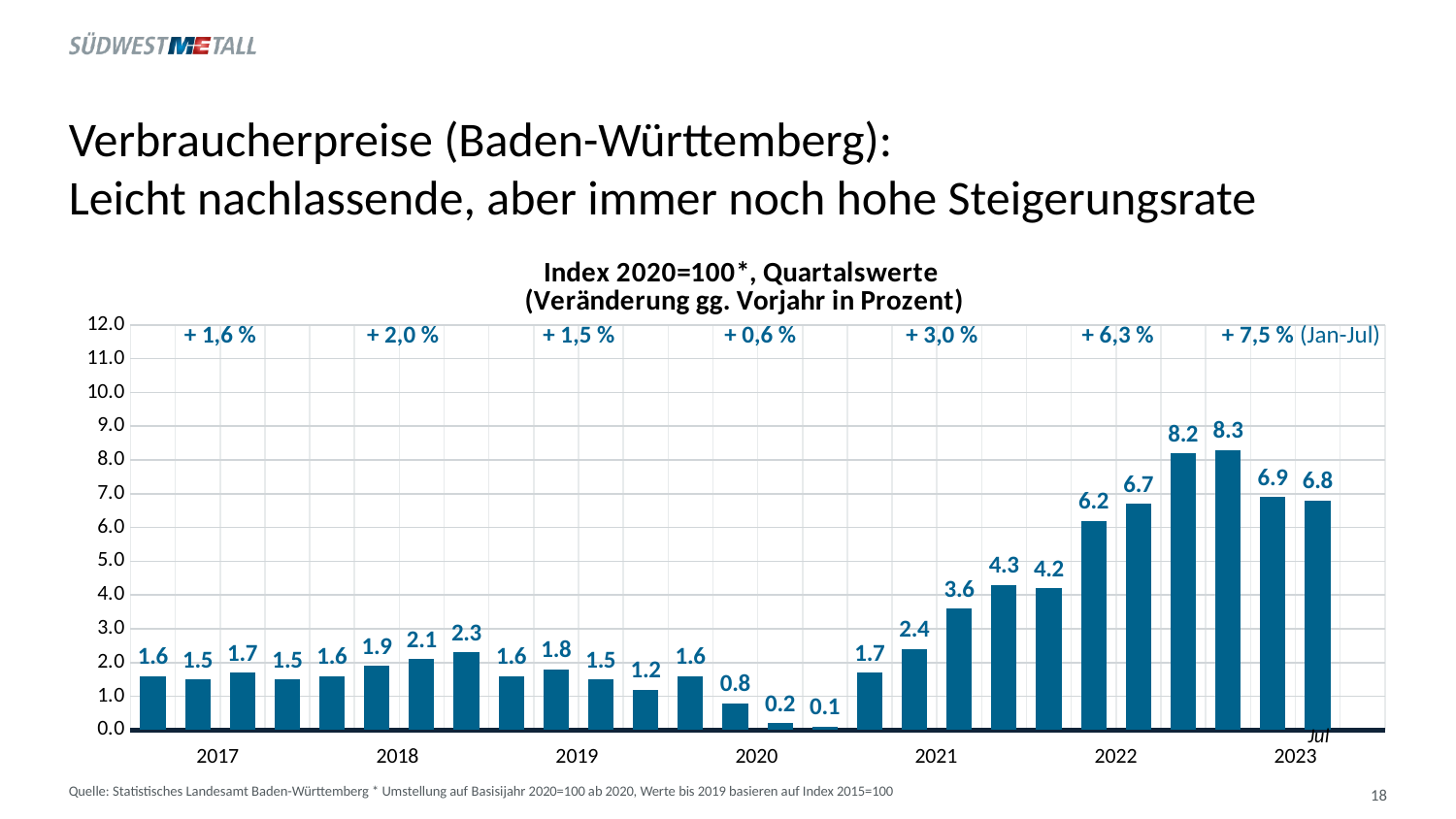
What is the lowest value shown by any bar in the chart? 0.1 What is the value of the last bar in the 2022 group? 8.2 What is the title of the chart? Index 2020=100*, Quartalswerte (Veränderung gg. Vorjahr in Prozent) Which is larger: the last bar of the 2021 group or the first bar of the 2022 group? the last bar of 2021 (4.3) What is the value of the first bar in the 2021 group? 1.7 What is the highest value shown by any bar in the chart? 8.3 What type of chart is shown on the slide? bar chart Do the bar values rise or fall across the 2020 group from left to right? fall What is the difference between the first bar of 2023 (8.3) and the last bar of 2022 (8.2)? 0.1 How many bars are plotted in the chart? 27 What annual change is annotated above the 2022 group? + 6,3 % What is the value of the last bar in the chart, labelled Jul 2023? 6.8